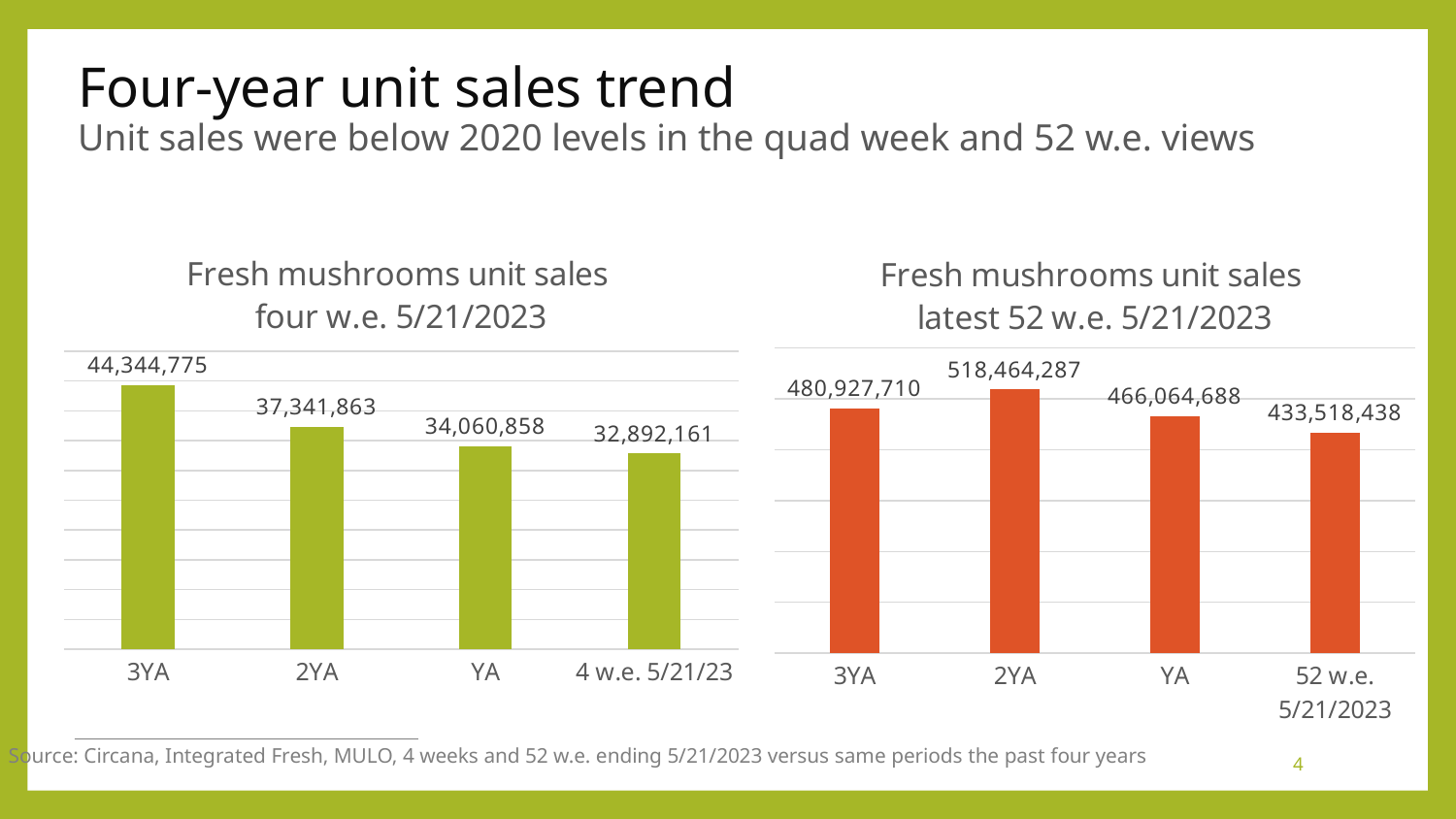
In the 'Fresh mushrooms unit sales latest 52 w.e. 5/21/2023' chart, what is the difference between the 2YA value and the 52 w.e. 5/21/2023 value? 84,945,849 What kind of chart is the 'Fresh mushrooms unit sales latest 52 w.e. 5/21/2023' chart? Bar chart How many categories are shown in the 'Fresh mushrooms unit sales four w.e. 5/21/2023' chart? 4 In the 'Fresh mushrooms unit sales latest 52 w.e. 5/21/2023' chart, which is larger: the value for 3YA or the value for 2YA? 2YA What colour are the bars in the 'Fresh mushrooms unit sales latest 52 w.e. 5/21/2023' chart? Orange In the 'Fresh mushrooms unit sales four w.e. 5/21/2023' chart, which category has the lowest value? 4 w.e. 5/21/23 In the 'Fresh mushrooms unit sales four w.e. 5/21/2023' chart, do the values rise or fall from 3YA to 4 w.e. 5/21/23? Fall In the 'Fresh mushrooms unit sales four w.e. 5/21/2023' chart, what is the value for 4 w.e. 5/21/23? 32,892,161 In the 'Fresh mushrooms unit sales latest 52 w.e. 5/21/2023' chart, what is the value for YA? 466,064,688 In the 'Fresh mushrooms unit sales four w.e. 5/21/2023' chart, what is the difference between the 3YA value and the 4 w.e. 5/21/23 value? 11,452,614 In the 'Fresh mushrooms unit sales four w.e. 5/21/2023' chart, what is the value for 3YA? 44,344,775 In the 'Fresh mushrooms unit sales latest 52 w.e. 5/21/2023' chart, which category has the highest value? 2YA